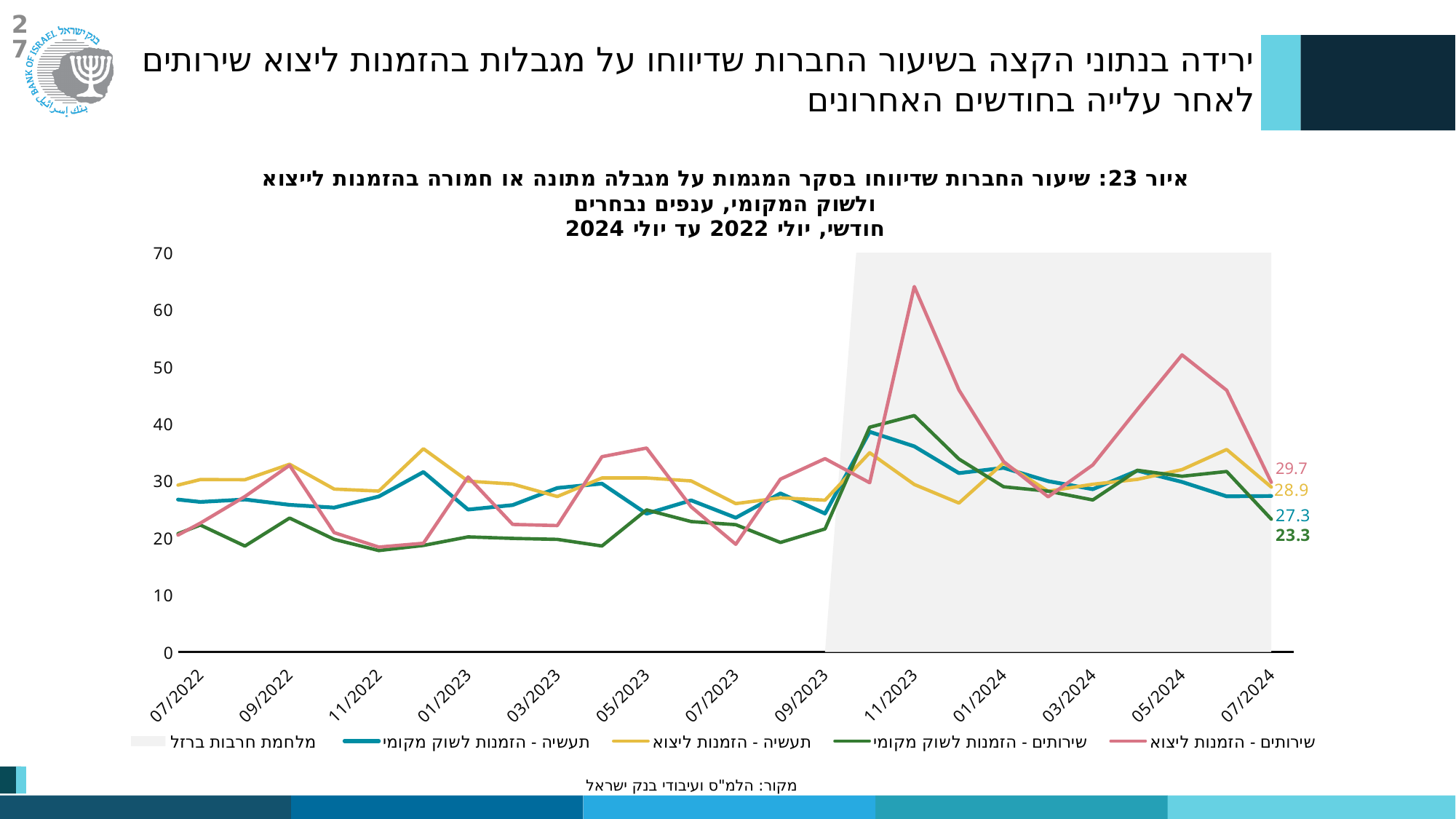
At 07/2024, which is larger: 'תעשיה - הזמנות ליצוא' or 'תעשיה - הזמנות לשוק מקומי'? תעשיה - הזמנות ליצוא What is the difference between the 'שירותים - הזמנות ליצוא' and 'שירותים - הזמנות לשוק מקומי' values at 07/2024? 6.4 Which series has the lowest value at 07/2024? שירותים - הזמנות לשוק מקומי What is the value of the 'שירותים - הזמנות ליצוא' series at 07/2024? 29.7 Is the peak value of the 'שירותים - הזמנות ליצוא' series around 11/2023 greater or less than 60? greater How many entries does the legend list? 5 What is the value of the 'תעשיה - הזמנות ליצוא' series at 07/2024? 28.9 What kind of chart is shown on the slide? line chart What is the value of the 'תעשיה - הזמנות לשוק מקומי' series at 07/2024? 27.3 What is the value of the 'שירותים - הזמנות לשוק מקומי' series at 07/2024? 23.3 Which series has the highest value at 07/2024? שירותים - הזמנות ליצוא What does the grey shaded area on the chart represent, according to the legend? מלחמת חרבות ברזל